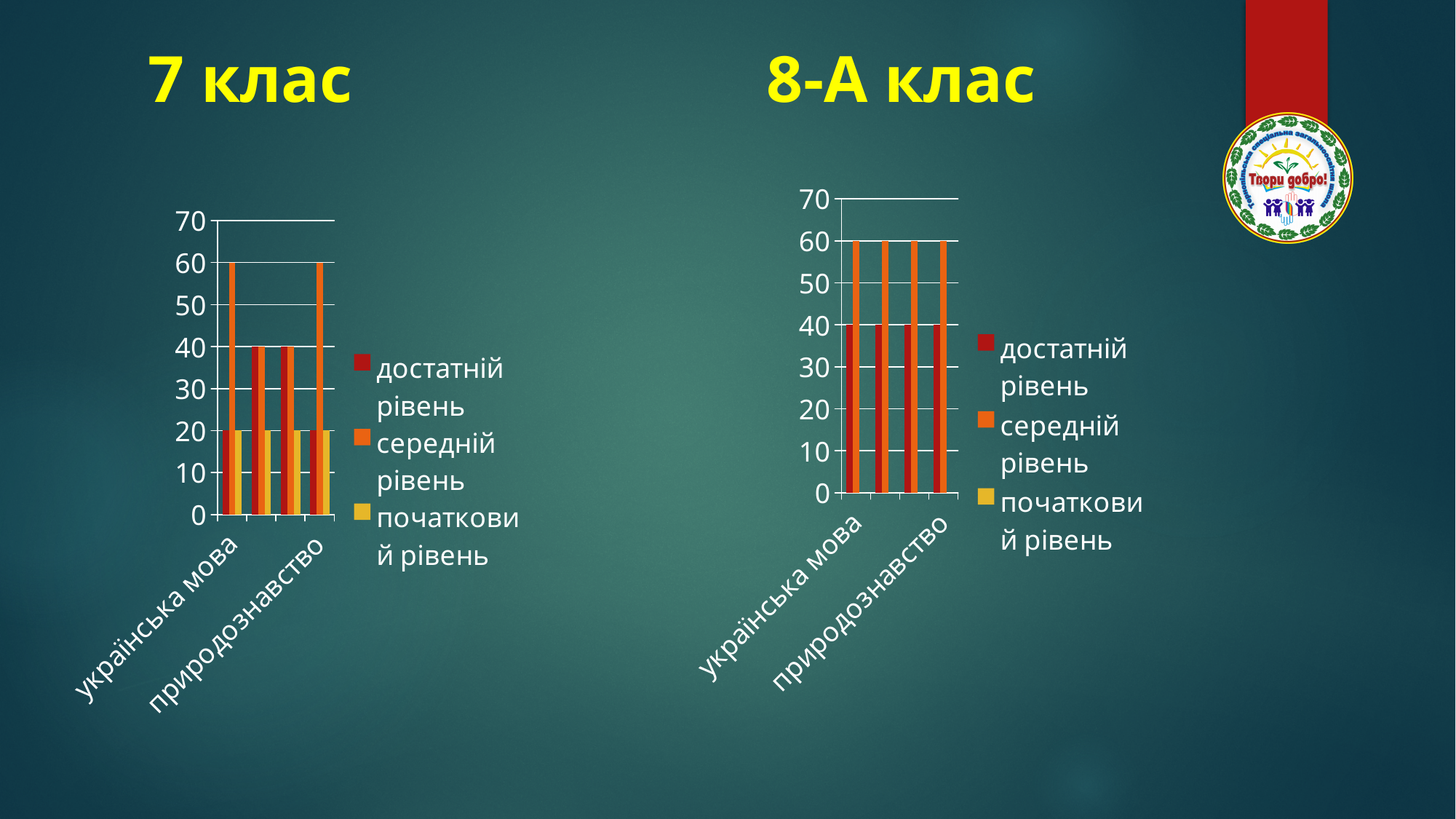
In the "8-А клас" chart, what is the value of достатній рівень for природознавство? 40 In the "7 клас" chart, what is the difference between середній рівень and достатній рівень for українська мова? 40 What kind of chart is the "7 клас" chart? bar chart In the "8-А клас" chart, is the value of середній рівень for природознавство greater or less than 50? greater In the "7 клас" chart, what is the value of середній рівень for українська мова? 60 In the "7 клас" chart, which is larger for українська мова: середній рівень or достатній рівень? середній рівень In the "7 клас" chart, what is the value of достатній рівень for природознавство? 20 In the "7 клас" chart, what is the value of достатній рівень for українська мова? 20 In the "8-А клас" chart, what is the value of середній рівень for українська мова? 60 How many series does the legend of the "8-А клас" chart list? 3 In the "8-А клас" chart, what colour represents середній рівень in the legend? orange In the "7 клас" chart, what is the value of початковий рівень for природознавство? 20